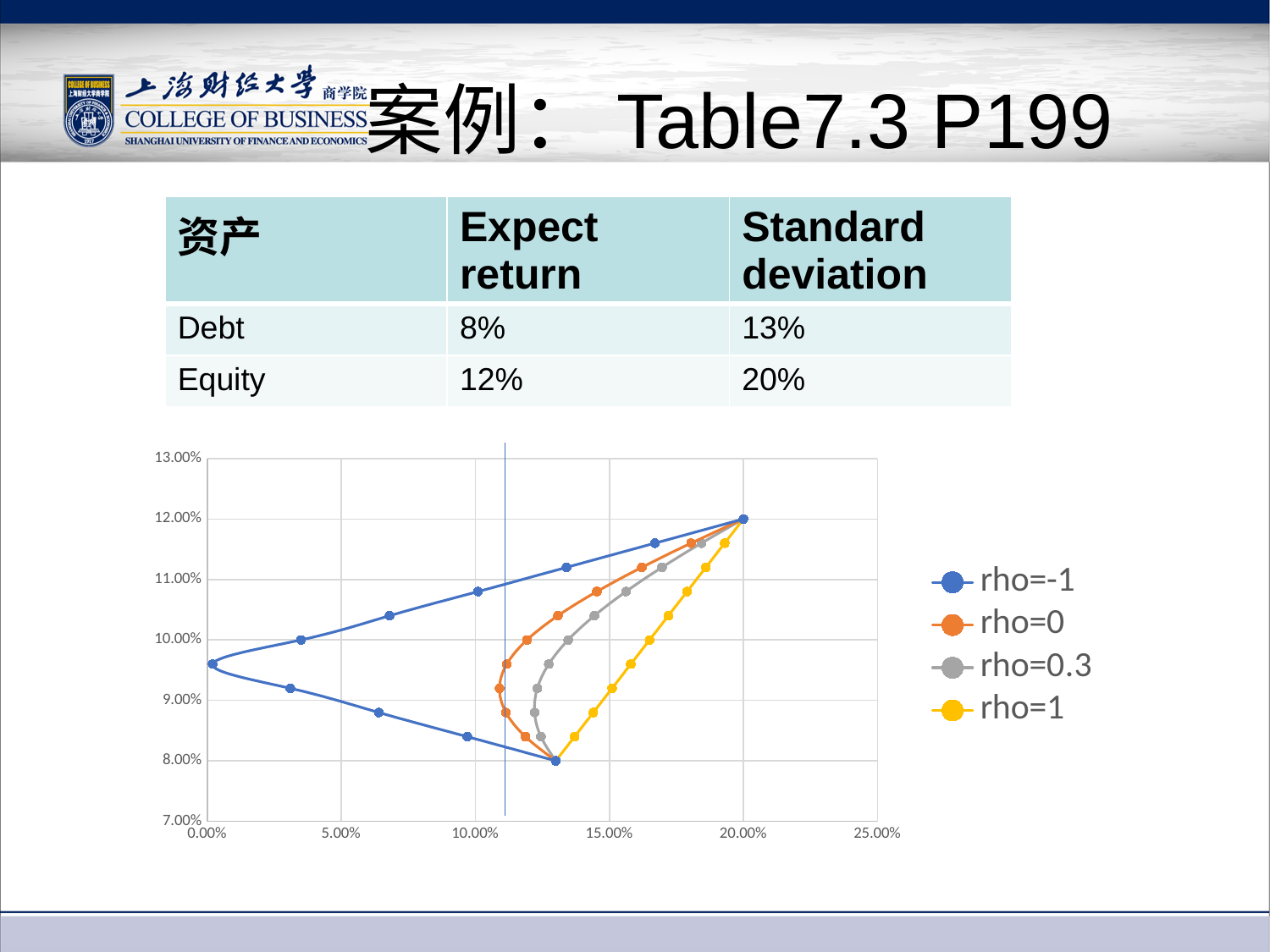
How many series does the chart legend list? 4 At what standard deviation do all four series meet at the top right of the chart? 20.00% Which series reaches the lowest standard deviation on the chart? rho=-1 Which series is plotted as a straight line between the two endpoints? rho=1 What is the lowest expected return value reached by the curves on the chart? 8.00% What are the four series named in the chart legend? rho=-1, rho=0, rho=0.3, rho=1 Is the minimum standard deviation reached by the rho=-1 series greater or less than 5.00%? less Is the minimum standard deviation reached by the rho=0 series greater or less than 10.00%? greater At an expected return of 10.00%, which series has the smaller standard deviation, rho=-1 or rho=1? rho=-1 What is the highest expected return value reached by the curves on the chart? 12.00% What kind of chart is shown on the slide? line chart Is the minimum standard deviation reached by the rho=0.3 series greater or less than 10.00%? greater